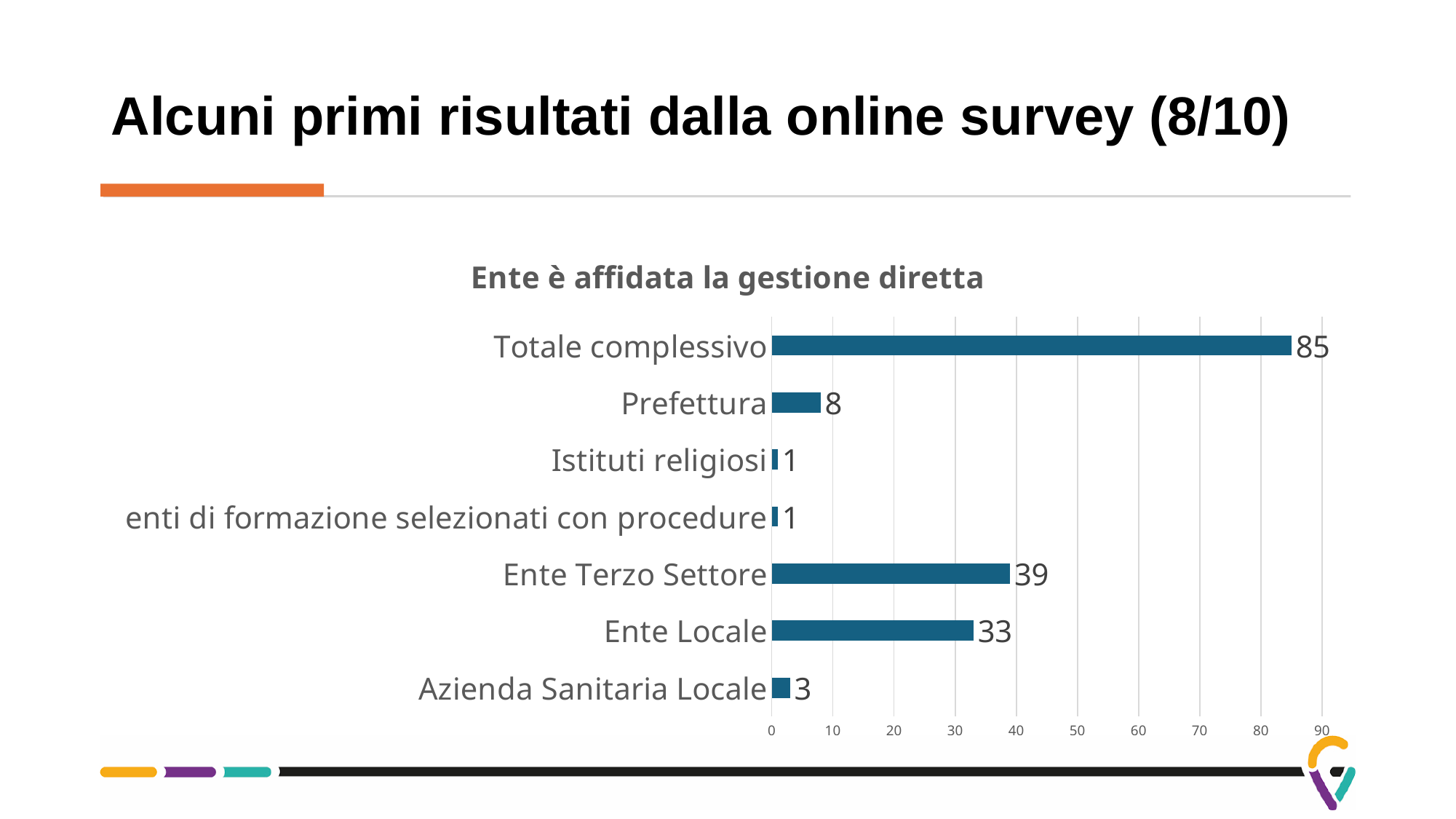
What is the difference between the values for Ente Terzo Settore and Ente Locale? 6 What is the value for Prefettura? 8 What is the value for Ente Terzo Settore? 39 How many categories are shown on the chart? 7 What kind of chart is shown on the slide? Bar chart What is the value for Totale complessivo? 85 Which is larger, the value for Prefettura or the value for Azienda Sanitaria Locale? Prefettura Is the value for Ente Locale greater or less than 30? greater What is the value for Ente Locale? 33 What is the title of the chart? Ente è affidata la gestione diretta What is the value for Azienda Sanitaria Locale? 3 Excluding Totale complessivo, which category has the highest value? Ente Terzo Settore